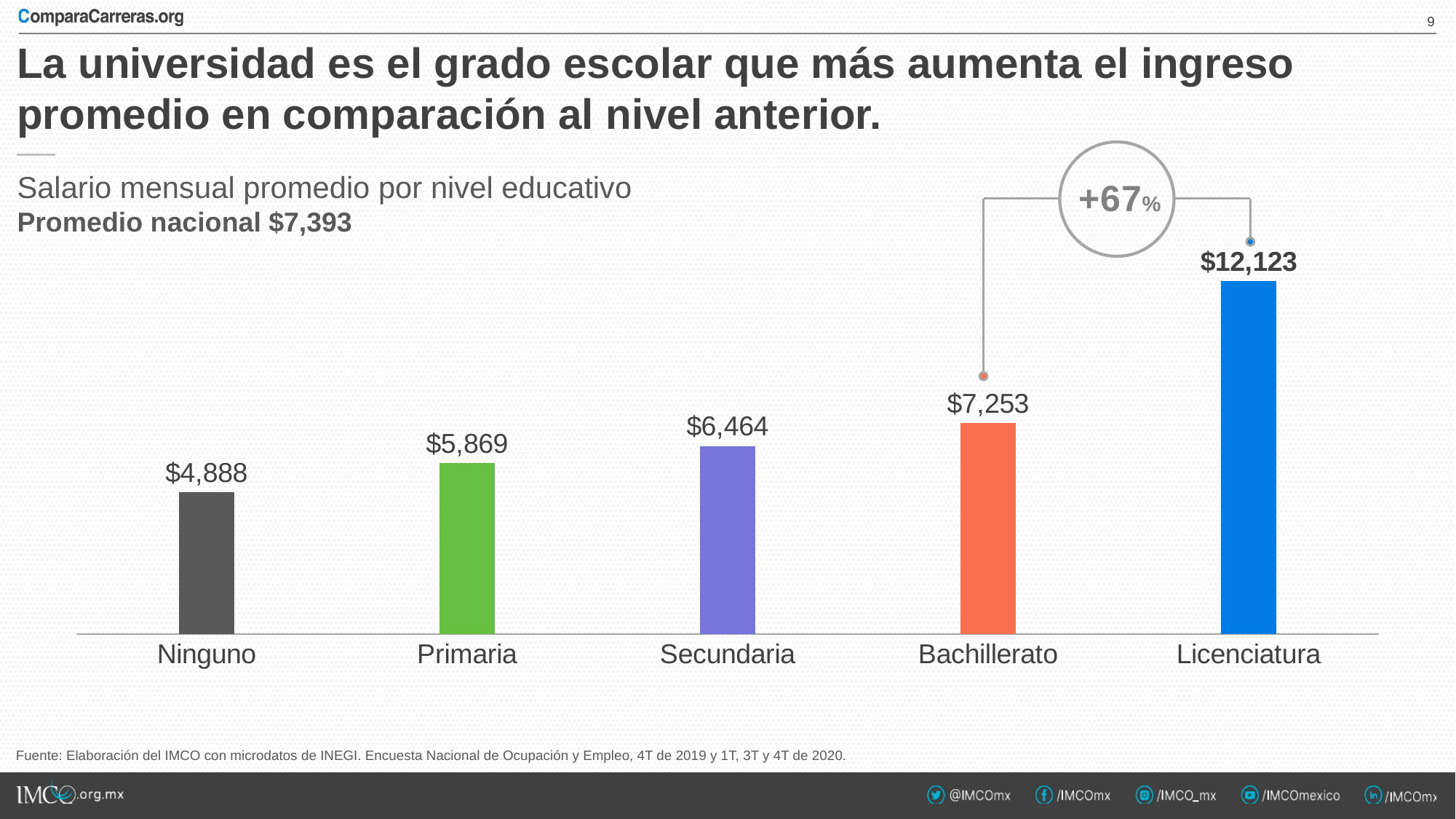
How many education levels are shown in the chart? 5 What is the average monthly salary for Secundaria? $6,464 Which education level has the lowest average monthly salary? Ninguno Which is larger, the salary for Secundaria or the salary for Primaria? Secundaria What kind of chart is shown on the slide? Bar chart What is the difference between the salary for Primaria and the salary for Ninguno? $981 Which education level has the highest average monthly salary? Licenciatura What is the average monthly salary for Ninguno? $4,888 What is the average monthly salary for Licenciatura? $12,123 Do the salary values rise or fall from Ninguno to Licenciatura? Rise What is the difference between the salary for Licenciatura and the salary for Bachillerato? $4,870 What percentage increase is shown between Bachillerato and Licenciatura? +67%